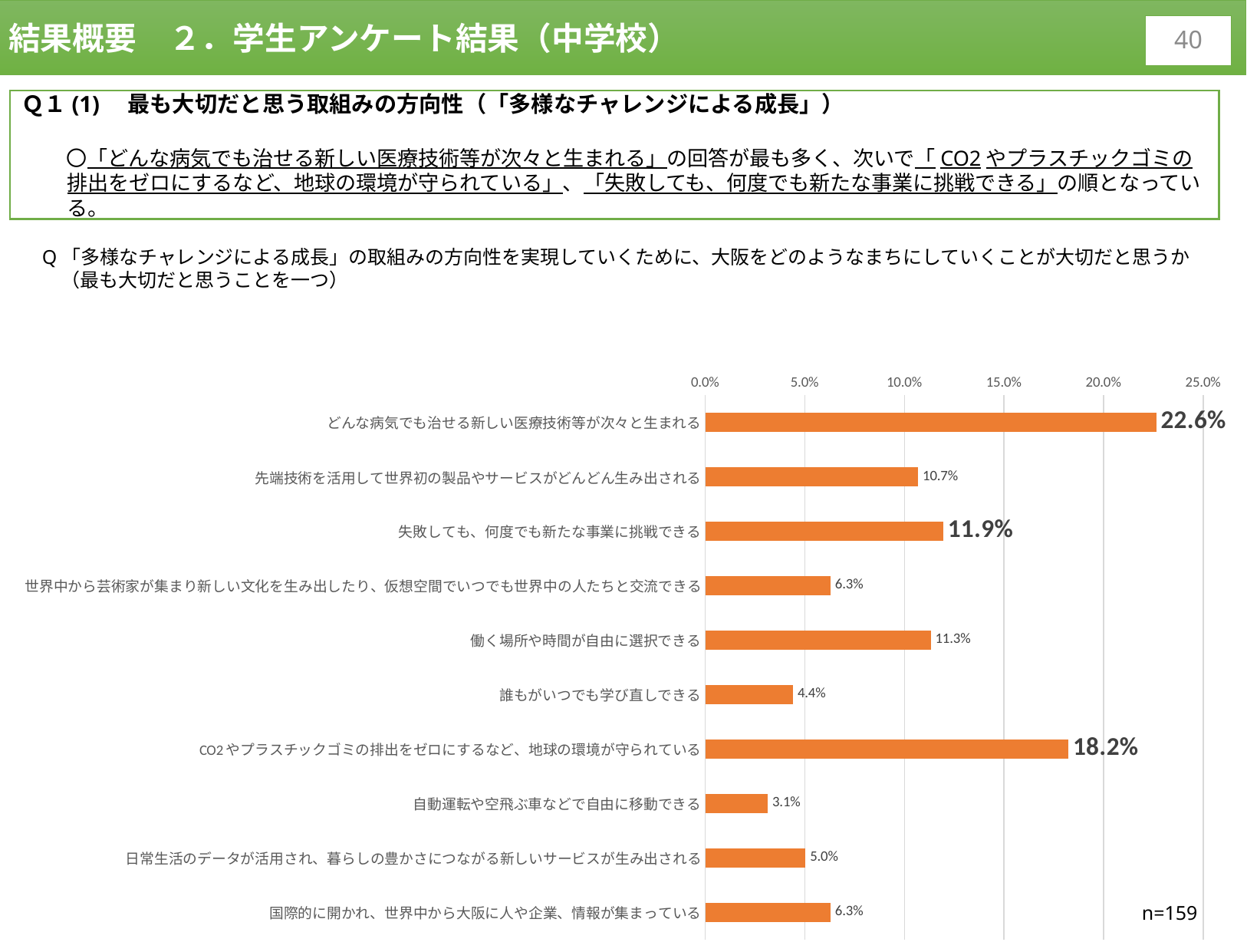
What is the value for 「自動運転や空飛ぶ車などで自由に移動できる」? 3.1% Is the value for 「誰もがいつでも学び直しできる」 greater or less than 5.0%? less Which is larger: the value for 「失敗しても、何度でも新たな事業に挑戦できる」 or 「先端技術を活用して世界初の製品やサービスがどんどん生み出される」? 失敗しても、何度でも新たな事業に挑戦できる What kind of chart is shown on the slide? bar chart Which category has the highest value? どんな病気でも治せる新しい医療技術等が次々と生まれる Which category has the lowest value? 自動運転や空飛ぶ車などで自由に移動できる What is the value for 「CO2やプラスチックゴミの排出をゼロにするなど、地球の環境が守られている」? 18.2% What is the sample size (n) shown on the chart? n=159 What is the value for 「働く場所や時間が自由に選択できる」? 11.3% What is the difference between the values for 「どんな病気でも治せる新しい医療技術等が次々と生まれる」 and 「CO2やプラスチックゴミの排出をゼロにするなど、地球の環境が守られている」? 4.4% How many categories are shown in the chart? 10 What is the value for 「どんな病気でも治せる新しい医療技術等が次々と生まれる」? 22.6%